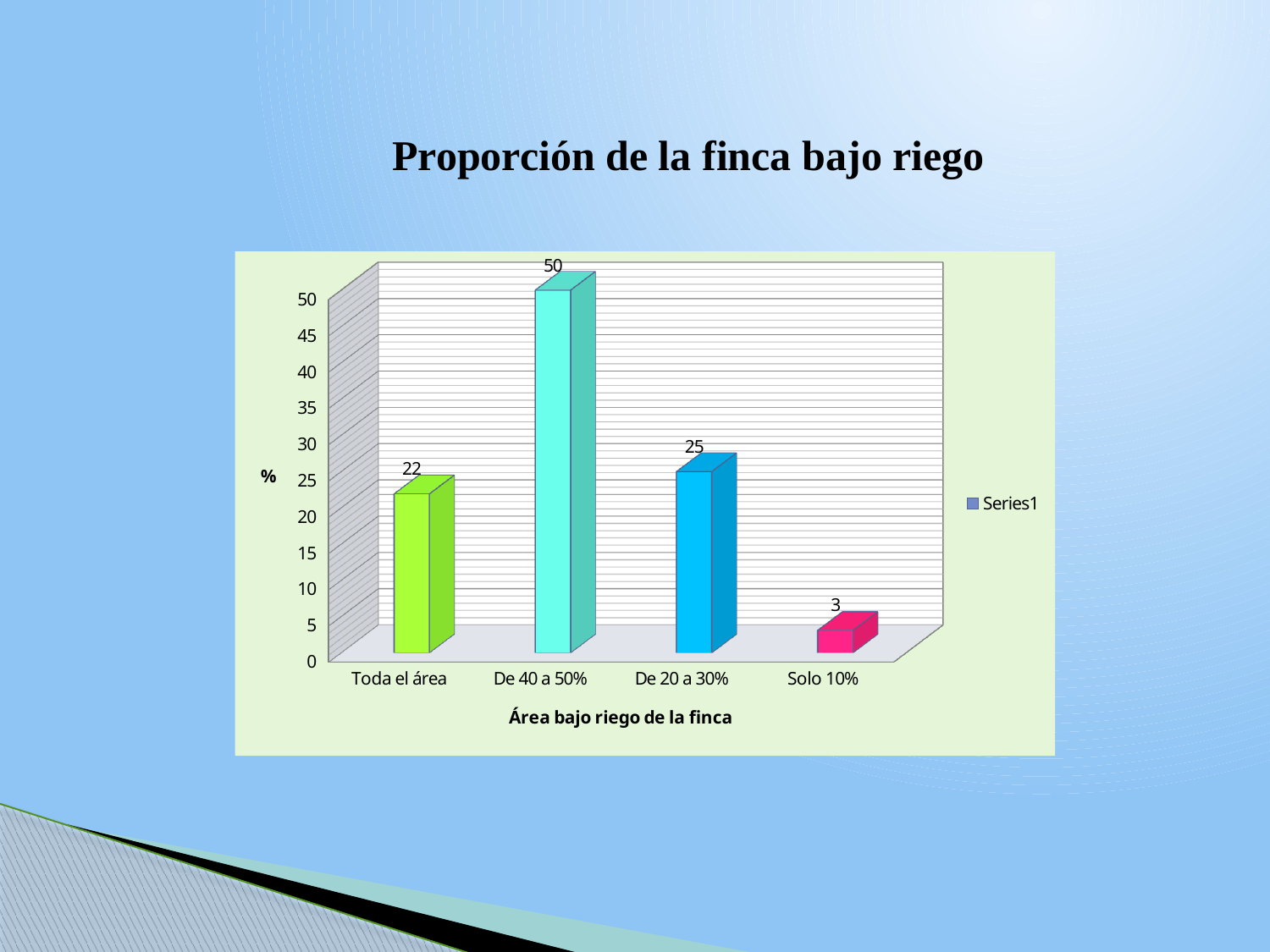
Which category has the lowest value? Solo 10% How many categories are shown on the x axis? 4 What kind of chart is shown? Bar chart What is the value for "De 20 a 30%"? 25 What is the value for "Solo 10%"? 3 What is the title of the chart? Proporción de la finca bajo riego Which is larger, the value for "Toda el área" or the value for "De 20 a 30%"? De 20 a 30% What is the value for "De 40 a 50%"? 50 Which category has the highest value? De 40 a 50% How many series does the legend list? 1 What is the value for "Toda el área"? 22 What is the difference between the values for "De 40 a 50%" and "De 20 a 30%"? 25